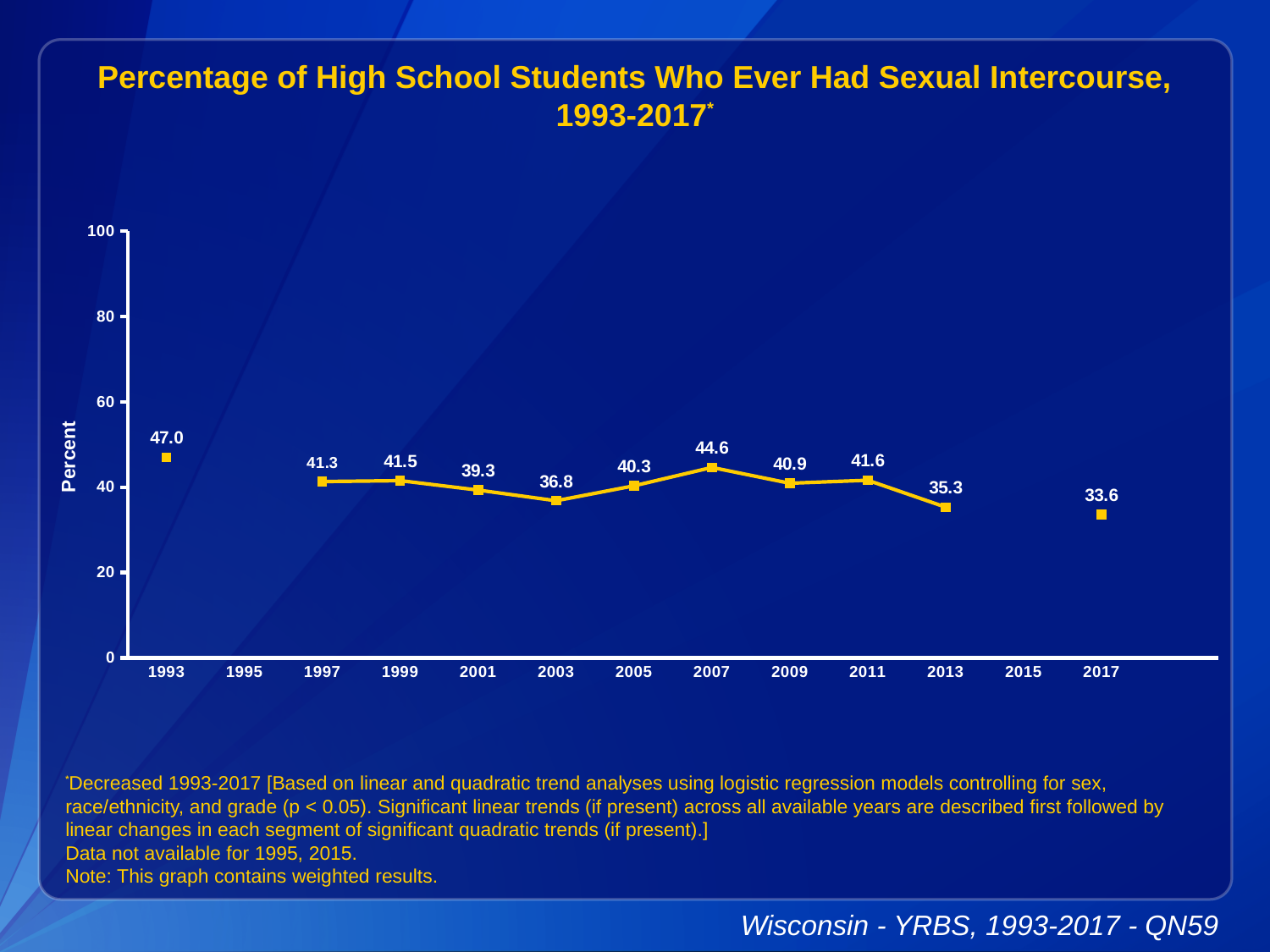
What was the percentage of high school students who ever had sexual intercourse in 1993? 47.0 What is the difference between the 1993 value and the 2017 value? 13.4 Which year has the larger value, 2003 or 2007? 2007 Which year has the highest value on the chart? 1993 Is the value for 2013 greater or less than 40? less Overall, do the values rise or fall from 1993 to 2017? fall What is the label on the y axis? Percent What value is shown for 2007? 44.6 What kind of chart is shown on the slide? line chart Which year has the lowest value on the chart? 2017 What value is shown for 2017? 33.6 How many years have data points plotted on the chart? 11